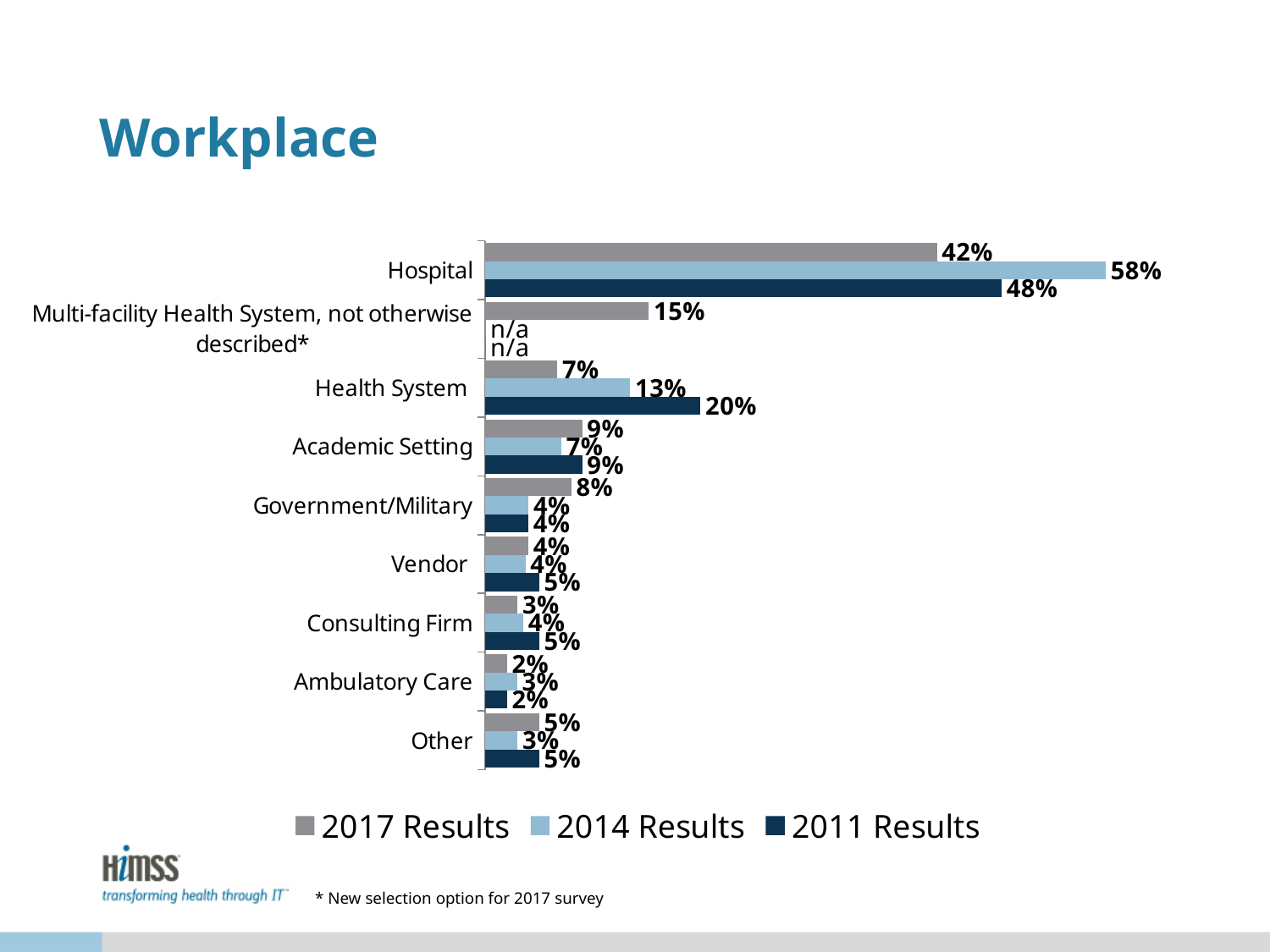
What is the 2014 Results value for Hospital? 58% What is the difference between the 2014 Results and 2017 Results values for Hospital? 16% What is the 2017 Results value for Multi-facility Health System, not otherwise described? 15% What is the 2011 Results value for Health System? 20% What is the difference between the 2011 Results and 2017 Results values for Health System? 13% Which category has the lowest 2017 Results value? Ambulatory Care What is the 2017 Results value for Government/Military? 8% How many series does the legend list? 3 What kind of chart is shown on the slide? Bar chart Which category has the highest 2017 Results value? Hospital How many categories are shown on the chart? 9 Which is larger for Hospital: the 2011 Results value or the 2017 Results value? 2011 Results